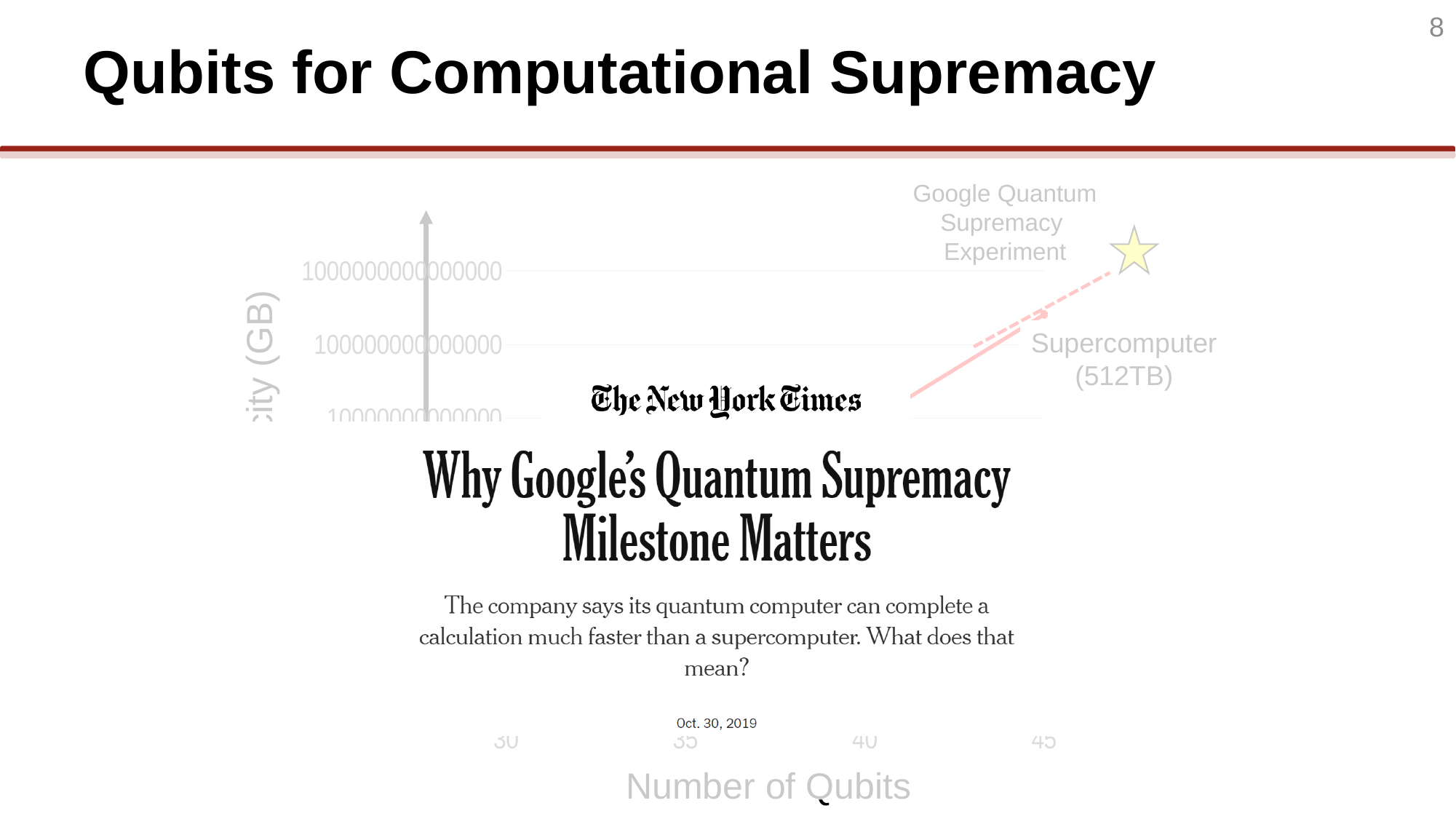
What is the label on the x axis of the chart? Number of Qubits Does the dashed line on the chart rise or fall as the number of qubits increases? rises What memory capacity is printed for the Supercomputer on the chart? 512TB What does the star marker on the chart represent? Google Quantum Supremacy Experiment Which is plotted higher on the chart, the Google Quantum Supremacy Experiment star or the Supercomputer point? Google Quantum Supremacy Experiment